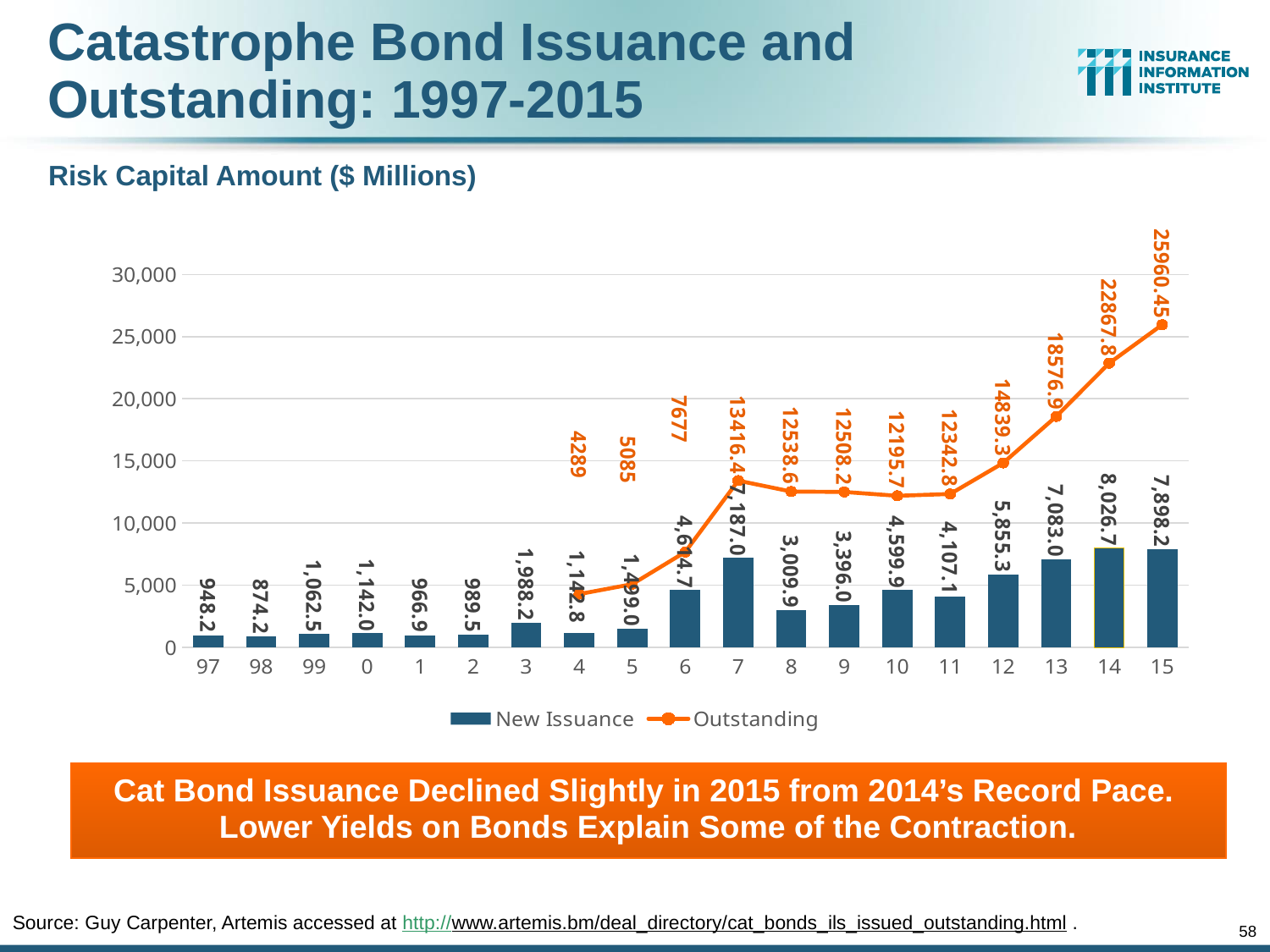
What was the New Issuance value for 1997 (labelled 97)? 948.2 What is the difference between the New Issuance values for 2014 (14) and 2015 (15)? 128.5 What was the New Issuance value for 2014 (labelled 14)? 8,026.7 Is the Outstanding value for 2013 (13) greater or less than 15,000? greater Which year has the lowest New Issuance value? 98 Which year has the highest New Issuance value? 14 How many years are shown on the x axis? 19 Does the Outstanding line rise or fall from 2011 (11) to 2015 (15)? Rise What was the Outstanding value for 2015 (labelled 15)? 25960.45 What kind of chart is used to show the New Issuance series? Bar chart How many series does the legend list? 2 Which is larger, the New Issuance value for 2007 (7) or for 2013 (13)? 7